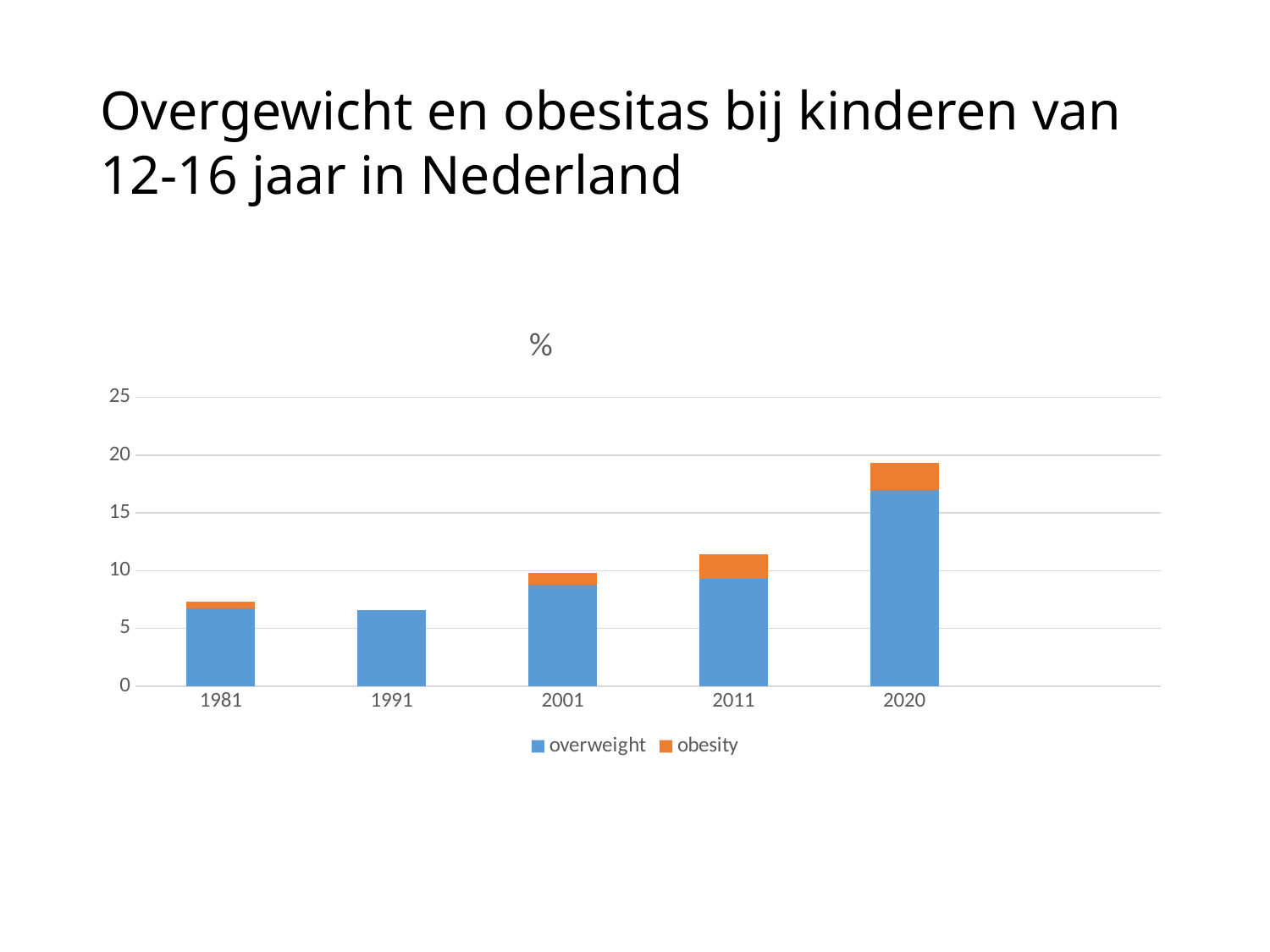
Is the total value for 2020 greater or less than 15? greater Which colour represents the obesity series in the chart? orange Which year has the highest total bar in the chart? 2020 Which year has the larger total bar, 2001 or 2011? 2011 Is the total value for 1991 greater or less than 10? less Is the total value for 2011 greater or less than 10? greater Which year has the lowest total bar in the chart? 1991 How many years are shown on the x axis of the chart? 5 Do the total values generally rise or fall from 1981 to 2020? rise How many series does the chart legend list? 2 What kind of chart is shown on the slide? stacked bar chart